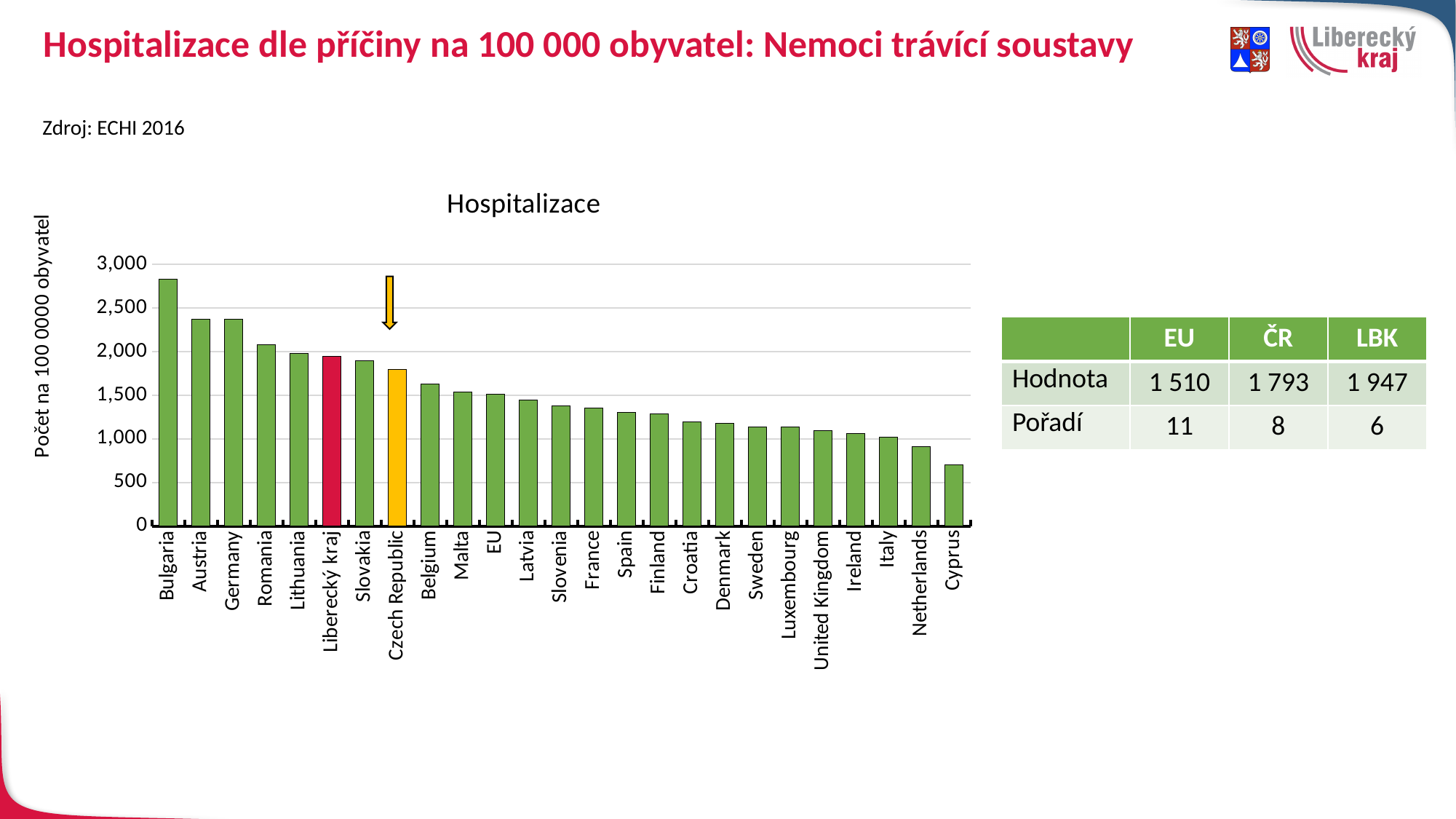
Which bar in the chart is coloured red? Liberecký kraj Which country or region has the highest hospitalization rate in the chart? Bulgaria Is the value for Czech Republic greater or less than 2,000? less How many bars (categories) are plotted in the chart? 25 Do the values rise or fall moving from left to right along the x axis? fall Which has the larger value, Slovakia or Czech Republic? Slovakia Is the value for Cyprus greater or less than 1,000? less Is the value for Bulgaria greater or less than 2,500? greater What kind of chart is shown on the slide? bar chart What is the title of the chart? Hospitalizace Which country has the lowest hospitalization rate in the chart? Cyprus